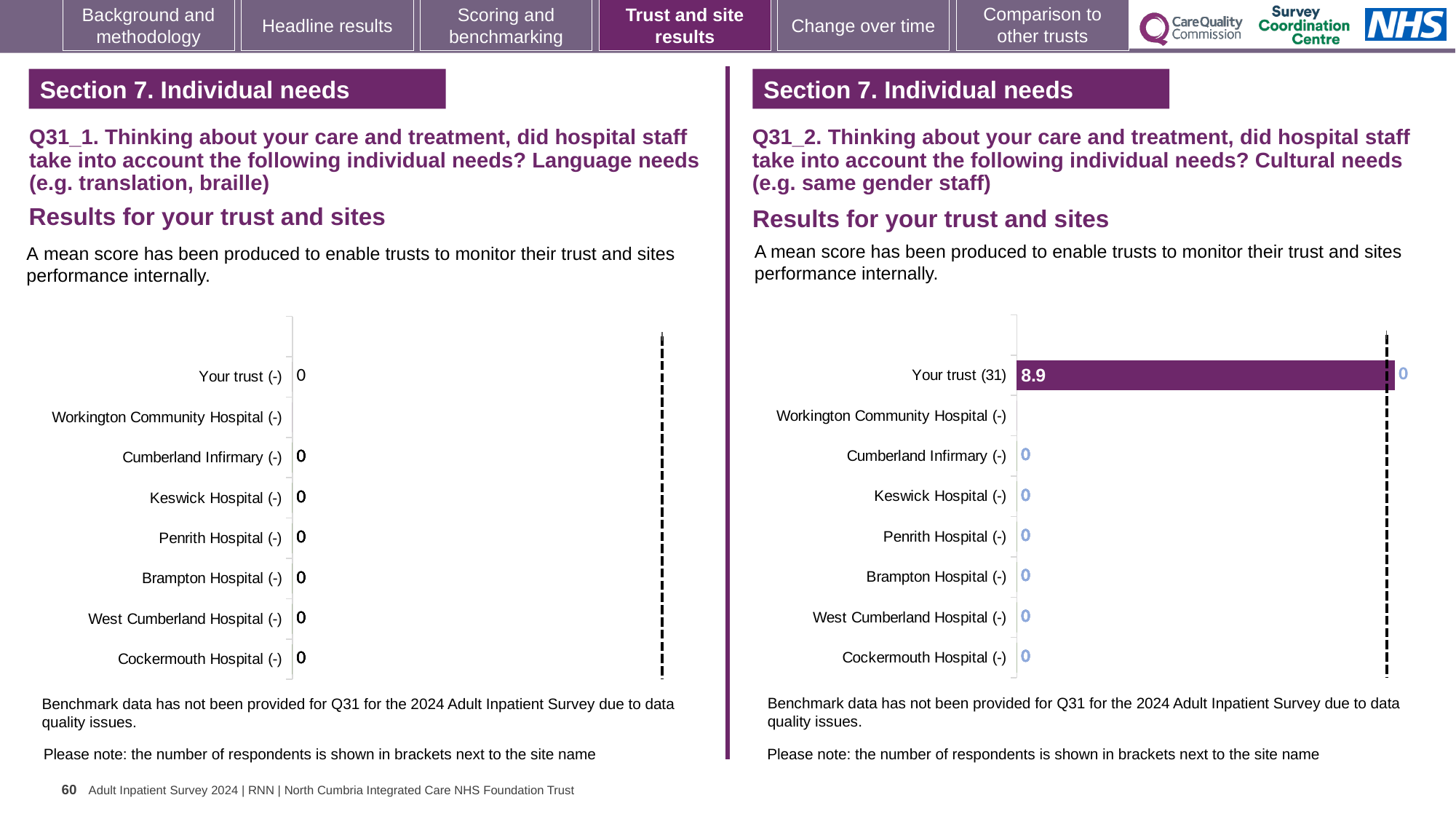
On the right chart (Q31_2, Cultural needs), which is larger: the value for Your trust (31) or the value for Keswick Hospital (-)? Your trust (31) On the right chart (Q31_2, Cultural needs), what is the difference between the value for Your trust (31) and the value for Penrith Hospital (-)? 8.9 On the left chart (Q31_1, Language needs), what value is shown for Cockermouth Hospital (-)? 0 On the right chart (Q31_2, Cultural needs), how many categories are listed on the vertical axis? 8 On the right chart (Q31_2, Cultural needs), what value is shown for Cumberland Infirmary (-)? 0 On the right chart (Q31_2, Cultural needs), how many respondents are shown in brackets next to Your trust? 31 On the right chart (Q31_2, Cultural needs), which category has the highest value? Your trust (31) On the left chart (Q31_1, Language needs), what value is shown for West Cumberland Hospital (-)? 0 What kind of chart is used on the right side of the slide (Q31_2, Cultural needs)? Bar chart On the left chart (Q31_1, Language needs), how many categories are listed on the vertical axis? 8 On the right chart (Q31_2, Cultural needs), what is the mean score for Your trust (31)? 8.9 On the left chart (Q31_1, Language needs), what value is shown for Your trust (-)? 0